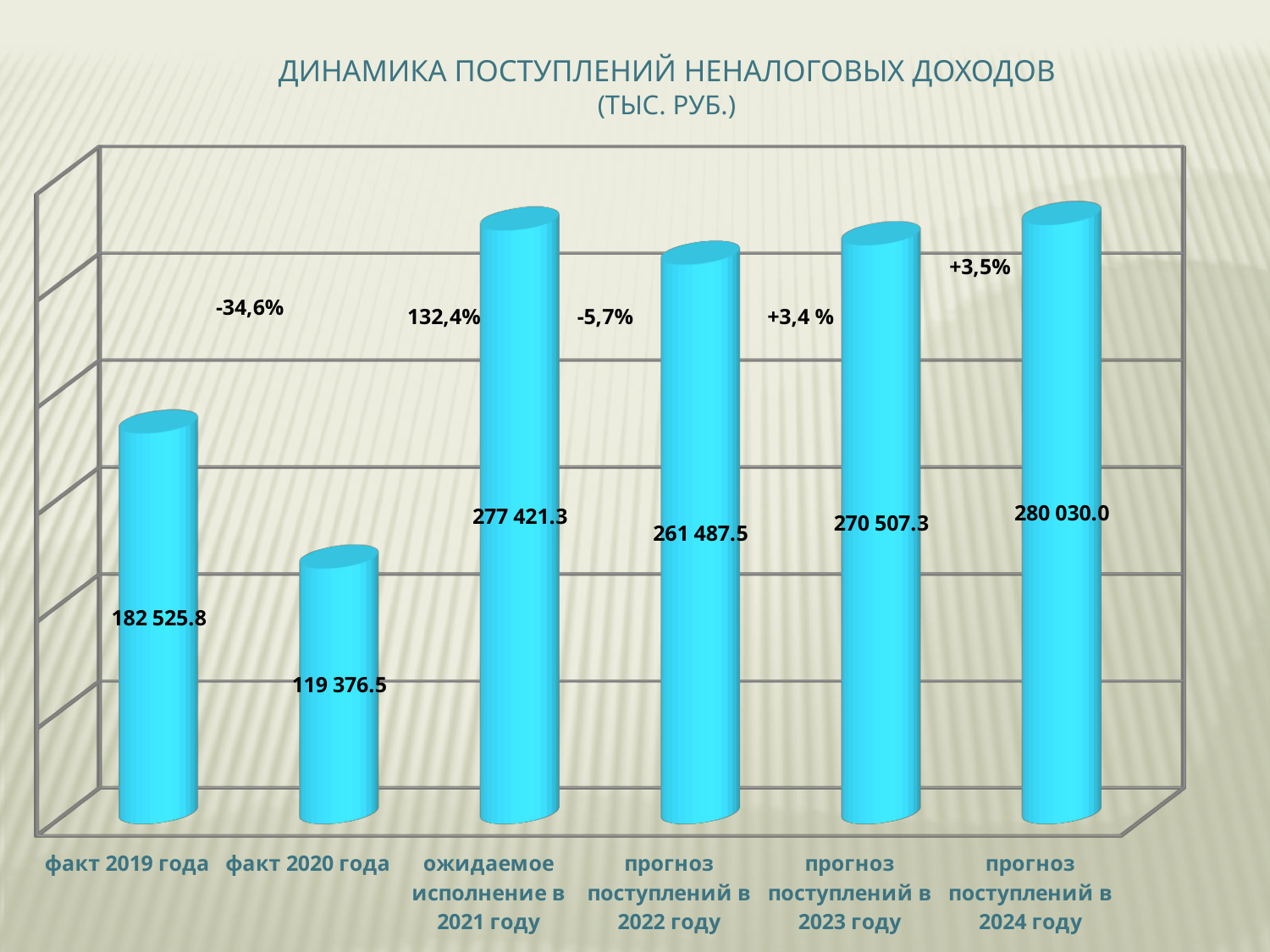
Which category has the highest value? прогноз поступлений в 2024 году Which category has the lowest value? факт 2020 года What is the value for факт 2019 года? 182 525.8 How many categories are shown on the chart? 6 What is the difference between the values for факт 2019 года and факт 2020 года? 63 149.3 What kind of chart is shown on the slide? bar chart Which is larger: the value for ожидаемое исполнение в 2021 году or the value for прогноз поступлений в 2022 году? ожидаемое исполнение в 2021 году What is the value for факт 2020 года? 119 376.5 What is the difference between the values for прогноз поступлений в 2024 году and прогноз поступлений в 2023 году? 9 522.7 Do the values rise or fall from прогноз поступлений в 2022 году to прогноз поступлений в 2024 году? rise What is the value for прогноз поступлений в 2024 году? 280 030.0 What is the value for ожидаемое исполнение в 2021 году? 277 421.3